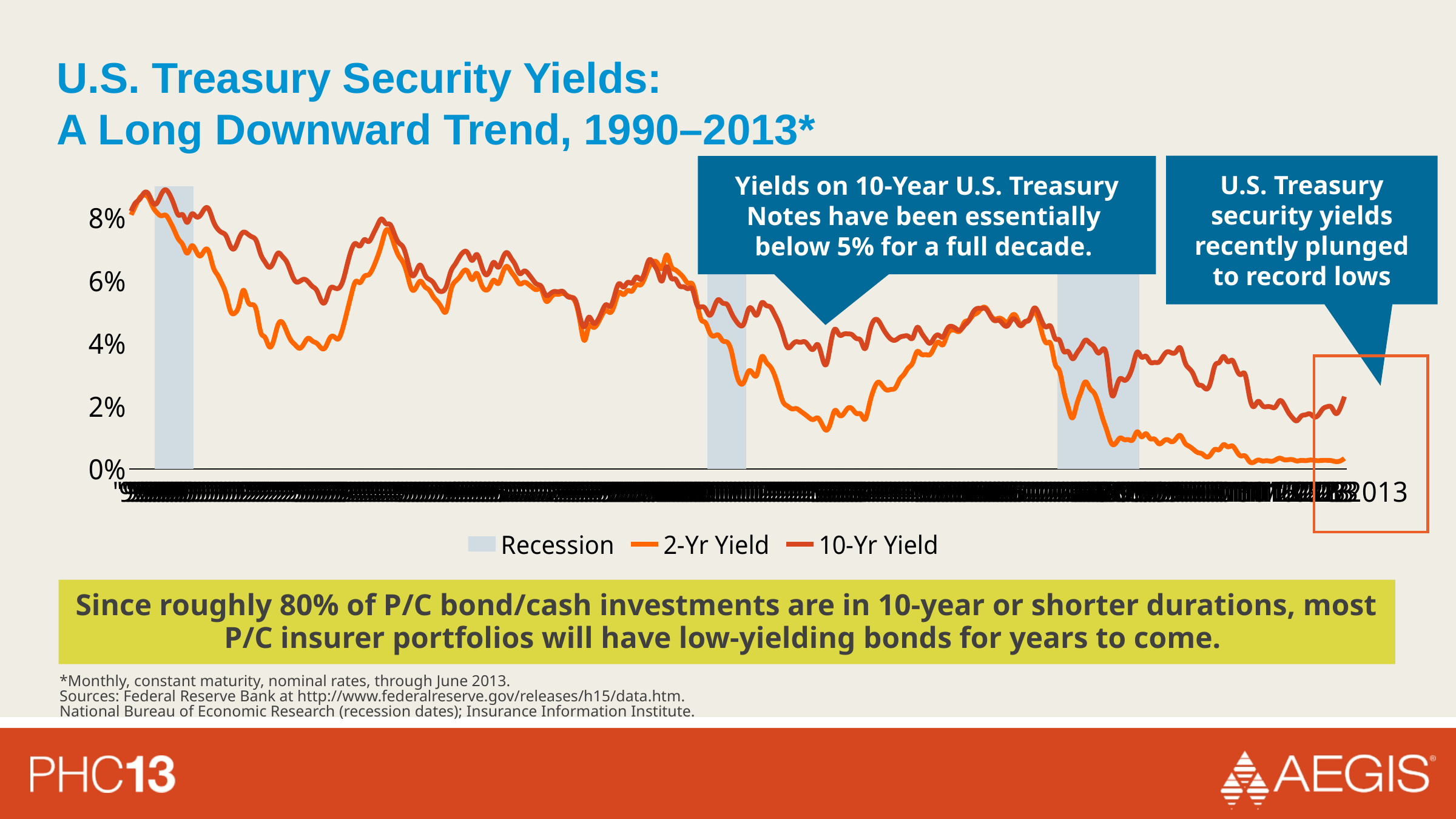
What is the overall trend of the yield lines from left to right across the chart? falling Is the 10-Yr Yield at the right end of the chart greater or less than 4%? less What is the title of the slide's chart? U.S. Treasury Security Yields: A Long Downward Trend, 1990–2013* What do the light blue shaded vertical bands on the chart represent? Recession Is the highest point reached by the 10-Yr Yield line greater or less than 8%? greater How many entries does the chart legend list? 3 At the right end of the chart (2013), which line is higher, the 2-Yr Yield or the 10-Yr Yield? 10-Yr Yield Is the lowest point reached by the 2-Yr Yield line greater or less than 2%? less What kind of chart is shown on the slide? line chart